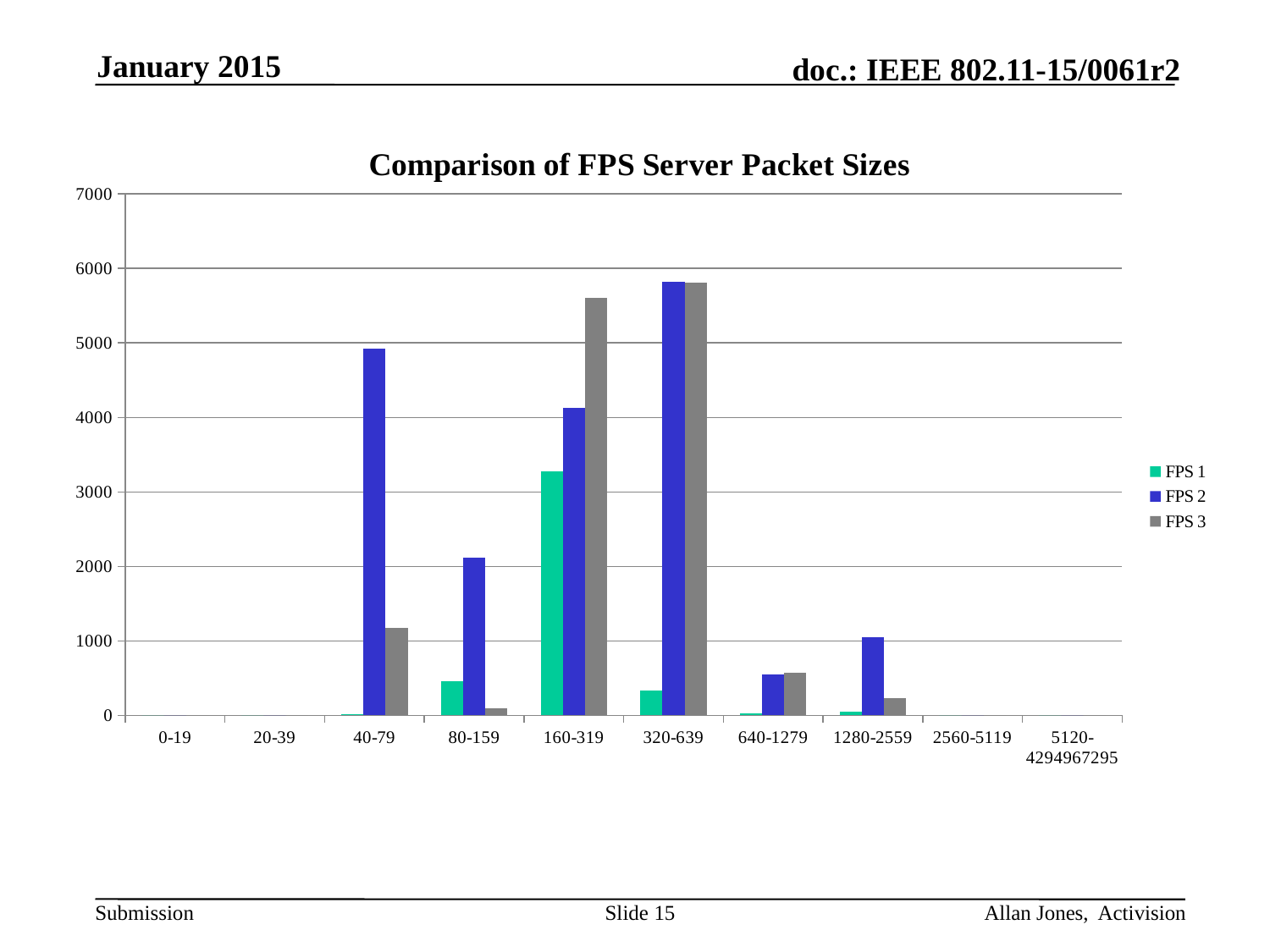
In the 80-159 category, which series has the larger value, FPS 1 or FPS 2? FPS 2 How many series does the legend list? 3 How many packet size categories are shown on the x axis? 10 Is the value for FPS 3 in the 1280-2559 category greater or less than 500? less Is the value for FPS 1 in the 160-319 category greater or less than 3000? greater Which packet size category has the highest value for FPS 1? 160-319 Is the value for FPS 3 in the 160-319 category greater or less than 5000? greater Which packet size category has the highest value for FPS 3? 320-639 What is the title of the chart? Comparison of FPS Server Packet Sizes In the 40-79 category, which series has the larger value, FPS 1 or FPS 3? FPS 3 What kind of chart is shown on the slide? bar chart